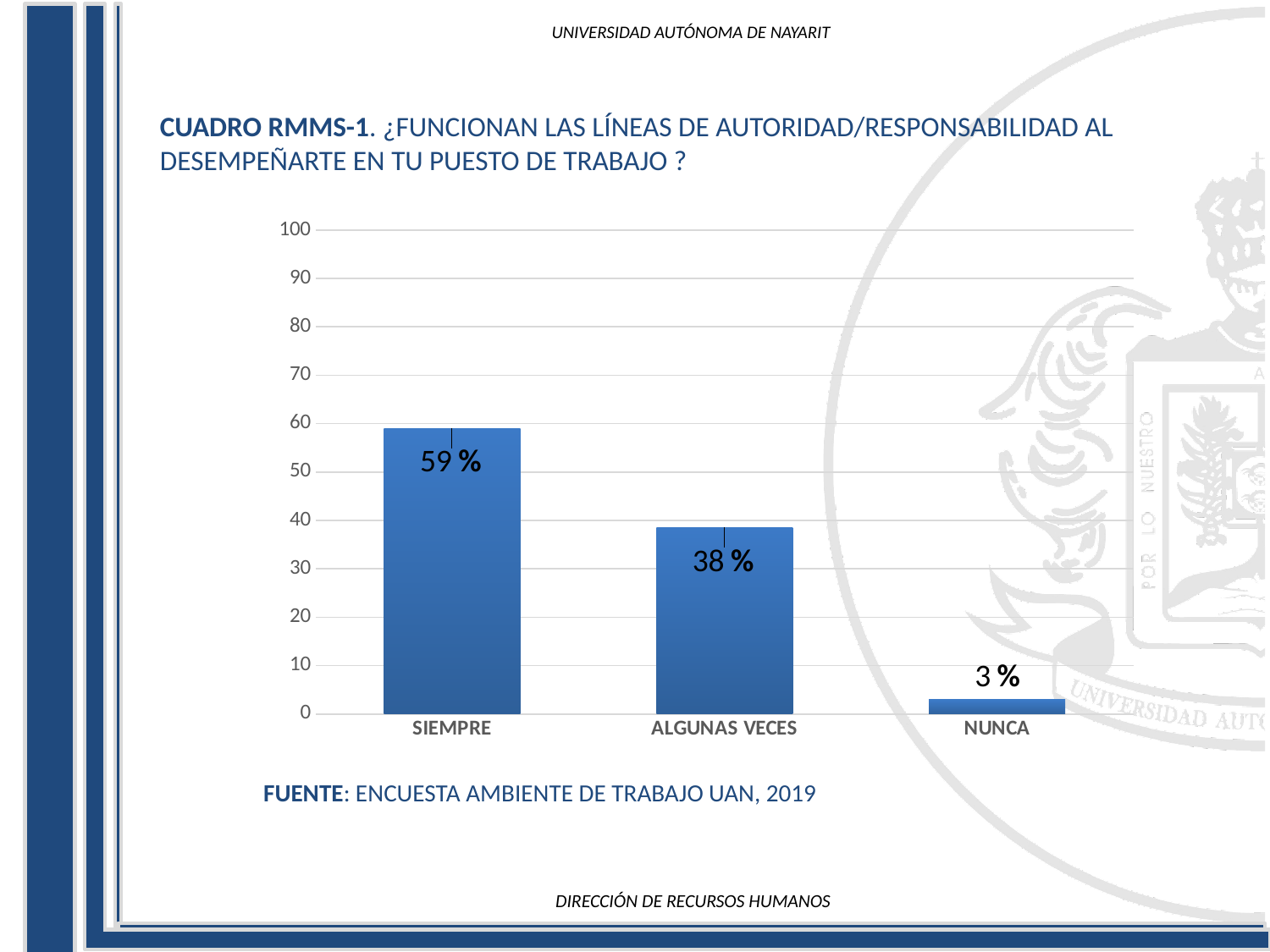
What is the value for SIEMPRE? 59 % How many categories are shown on the x axis? 3 Which is larger, the value for SIEMPRE or the value for ALGUNAS VECES? SIEMPRE What kind of chart is shown on the slide? bar chart What is the source cited below the chart? ENCUESTA AMBIENTE DE TRABAJO UAN, 2019 What is the value for NUNCA? 3 % What is the difference between the values for SIEMPRE and ALGUNAS VECES? 21 % Is the value for ALGUNAS VECES greater or less than 40? less Which category has the lowest value? NUNCA What is the difference between the values for ALGUNAS VECES and NUNCA? 35 % What is the value for ALGUNAS VECES? 38 % Which category has the highest value? SIEMPRE